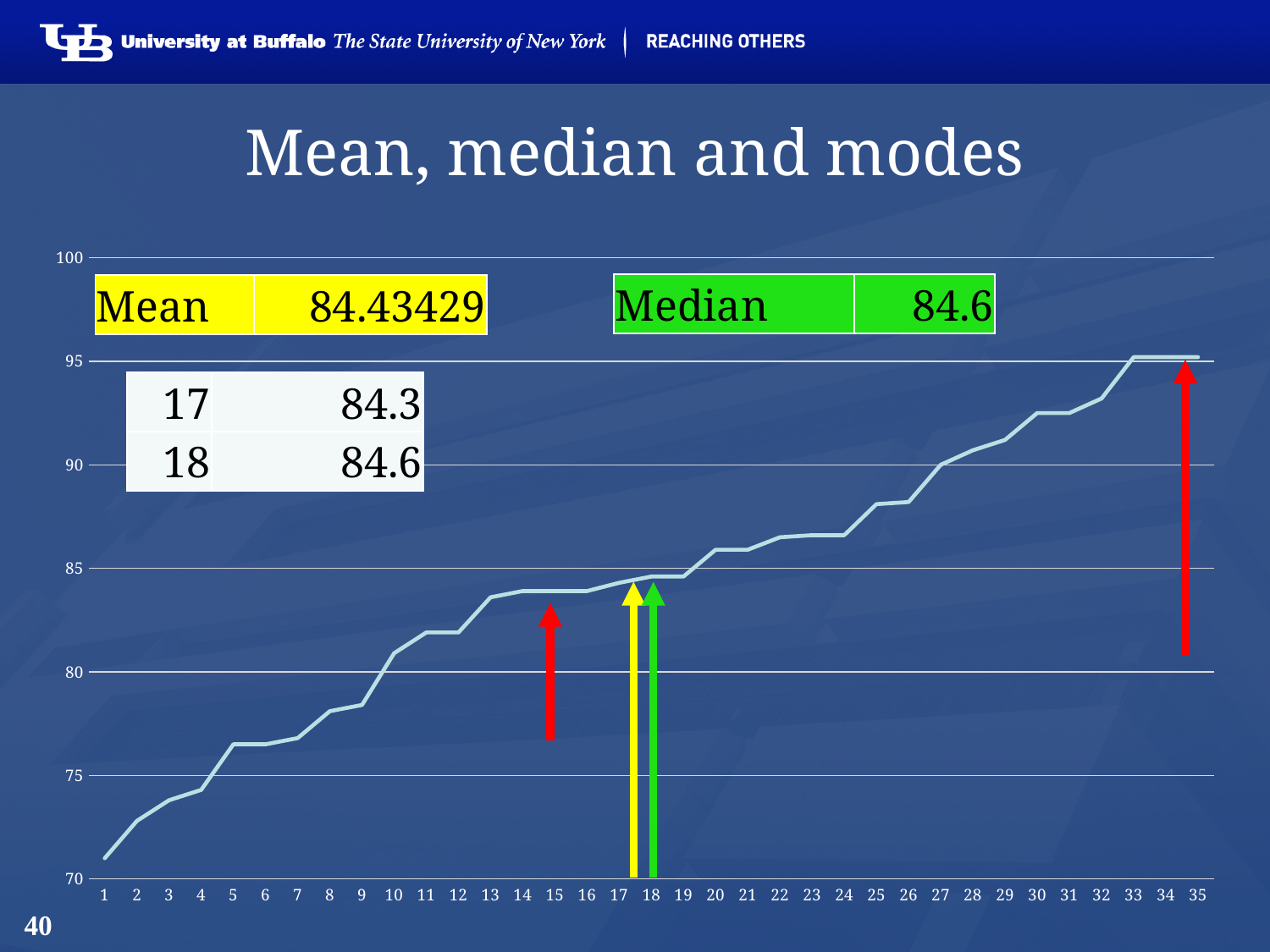
According to the table on the slide, what is the value at position 18? 84.6 According to the table on the slide, what is the value at position 17? 84.3 What kind of chart is shown on the slide? line chart What mean value is shown in the yellow box on the slide? 84.43429 How many data points are plotted along the x axis? 35 Is the value at position 35 greater or less than 90? greater What is the difference between the values at positions 18 and 17? 0.3 Do the plotted values rise or fall as the x axis goes from 1 to 35? rise Is the value at position 1 greater or less than 75? less What median value is shown in the green box on the slide? 84.6 Which position on the x axis has the lowest plotted value? 1 Which is larger, the value at position 30 or the value at position 10? position 30